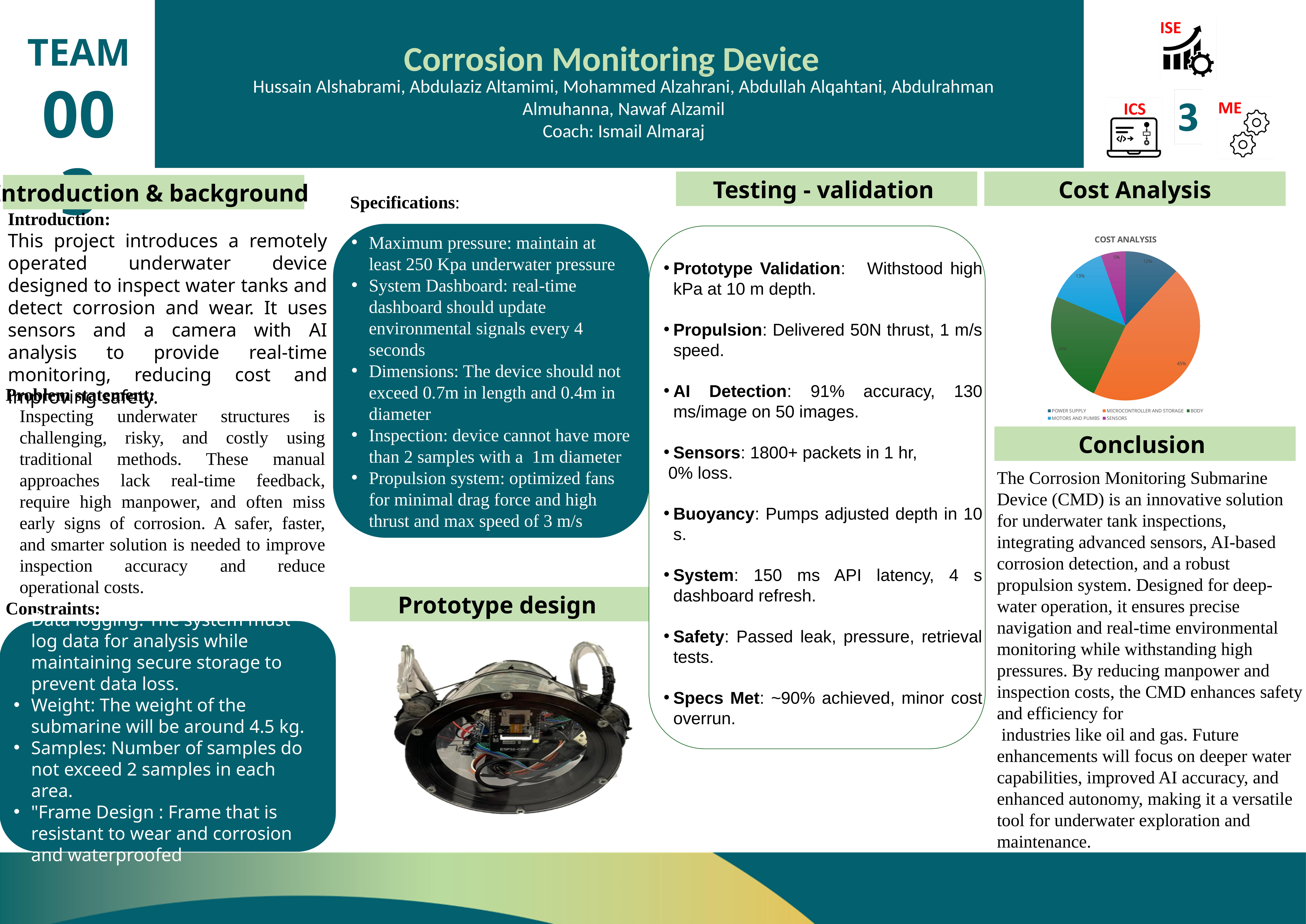
What share of the COST ANALYSIS pie does BODY take? 24% What is the value shown for POWER SUPPLY in the COST ANALYSIS pie chart? 12% What is the title of the pie chart? COST ANALYSIS What is the value shown for MOTORS AND PUMBS in the COST ANALYSIS pie chart? 13% Which category has the largest share in the COST ANALYSIS pie chart? MICROCONTROLLER AND STORAGE In the COST ANALYSIS pie chart, which is larger: BODY or POWER SUPPLY? BODY How many categories does the COST ANALYSIS pie chart have? 5 Which legend entry in the COST ANALYSIS pie chart is shown in orange? MICROCONTROLLER AND STORAGE In the COST ANALYSIS pie chart, what is the difference between the MICROCONTROLLER AND STORAGE share and the BODY share? 21% What kind of chart is shown under Cost Analysis? pie chart What share of the COST ANALYSIS pie does MICROCONTROLLER AND STORAGE take? 45% Which category has the smallest share in the COST ANALYSIS pie chart? SENSORS